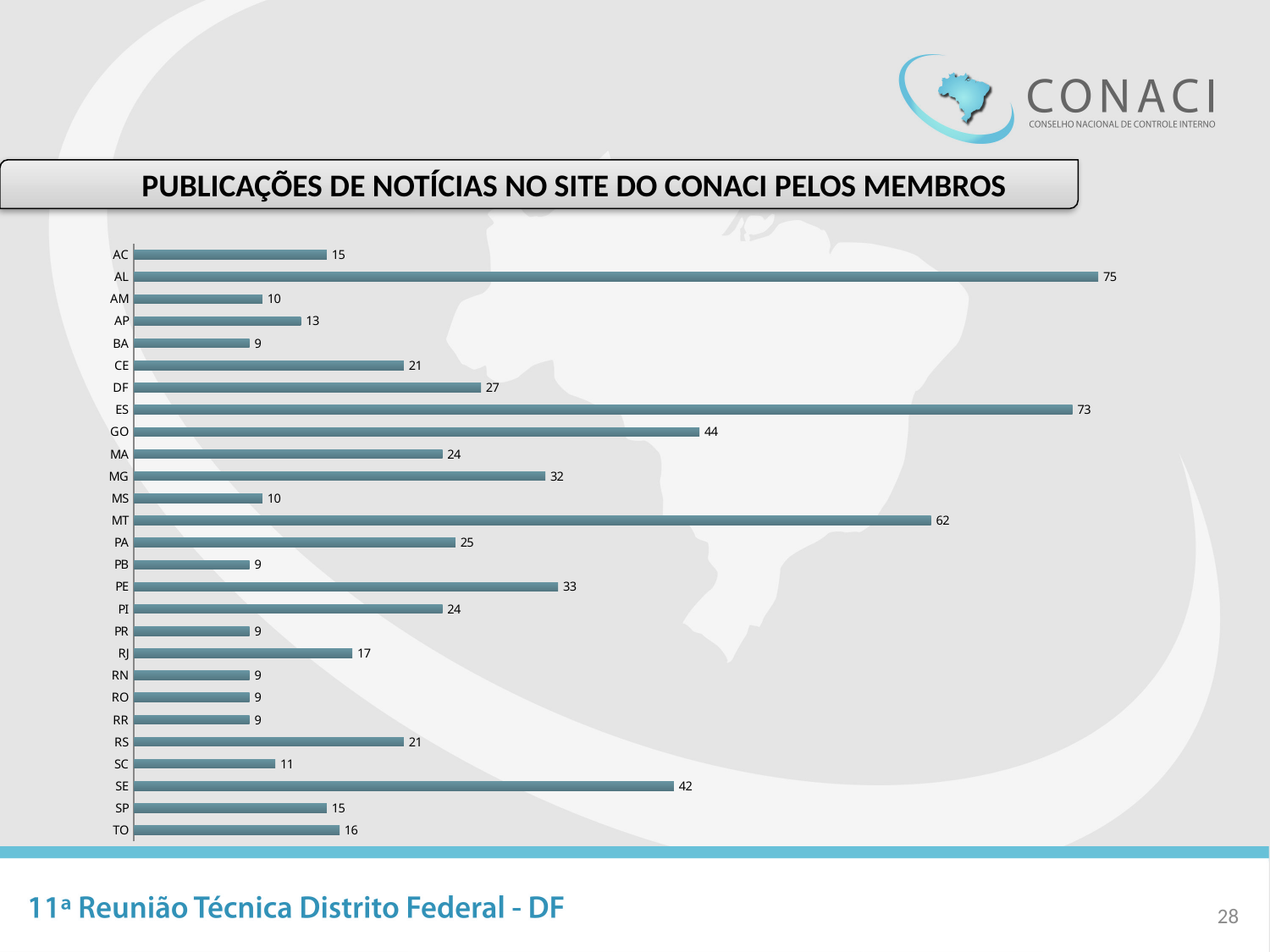
What is the value for MT? 62 What is the value for DF? 27 How many publications are shown for GO? 44 What is the difference between the values for AL and ES? 2 What is the title of the chart on the slide? PUBLICAÇÕES DE NOTÍCIAS NO SITE DO CONACI PELOS MEMBROS Which member has the highest number of publications? AL What is the value for SE? 42 What is the lowest value shown in the chart? 9 What is the difference between the values for MT and GO? 18 What type of chart is shown on the slide? bar chart How many members (categories) are shown in the chart? 27 Which has a larger value, PE or MG? PE